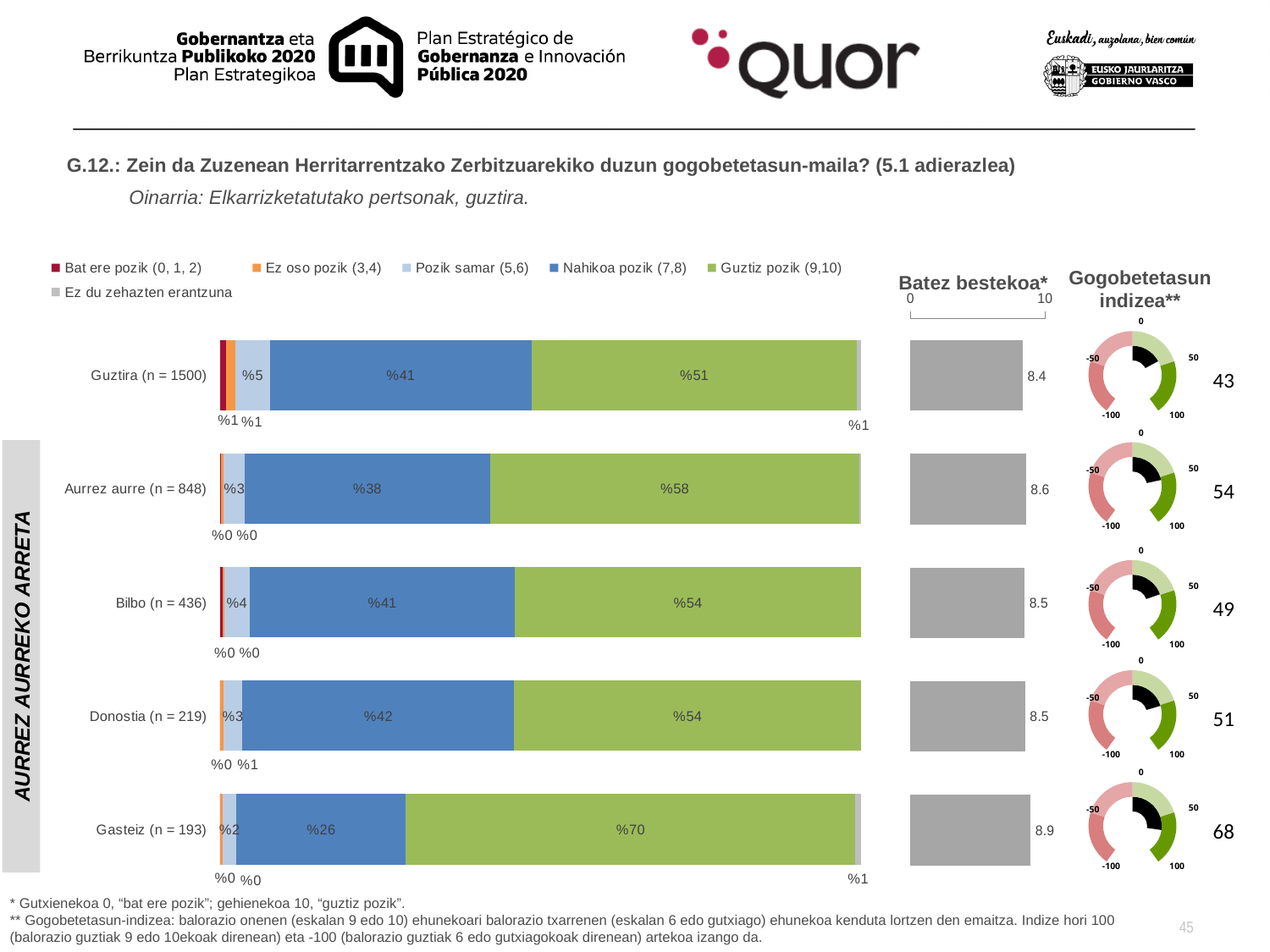
How many categories (rows) does the stacked bar chart show? 5 In the stacked bar chart, which category has the lowest 'Nahikoa pozik (7,8)' percentage? Gasteiz (n = 193) What kind of chart is the main chart showing satisfaction levels by category? Stacked bar chart In the stacked bar chart, what is the difference between the 'Guztiz pozik (9,10)' percentages of Gasteiz (n = 193) and Aurrez aurre (n = 848)? 12 percentage points In the 'Gogobetetasun indizea**' gauges, what is the index value for Bilbo (n = 436)? 49 In the stacked bar chart, what percentage of Gasteiz (n = 193) respondents answered 'Nahikoa pozik (7,8)'? %26 How many series does the legend of the stacked bar chart list? 6 In the 'Batez bestekoa*' chart, which category has the lowest average score? Guztira (n = 1500) In the stacked bar chart, is the 'Nahikoa pozik (7,8)' share larger for Donostia (n = 219) or for Aurrez aurre (n = 848)? Donostia (n = 219) In the stacked bar chart, what percentage of Guztira (n = 1500) respondents answered 'Guztiz pozik (9,10)'? %51 In the 'Batez bestekoa*' chart, what is the average score for Gasteiz (n = 193)? 8.9 In the stacked bar chart, which category has the highest 'Guztiz pozik (9,10)' percentage? Gasteiz (n = 193)